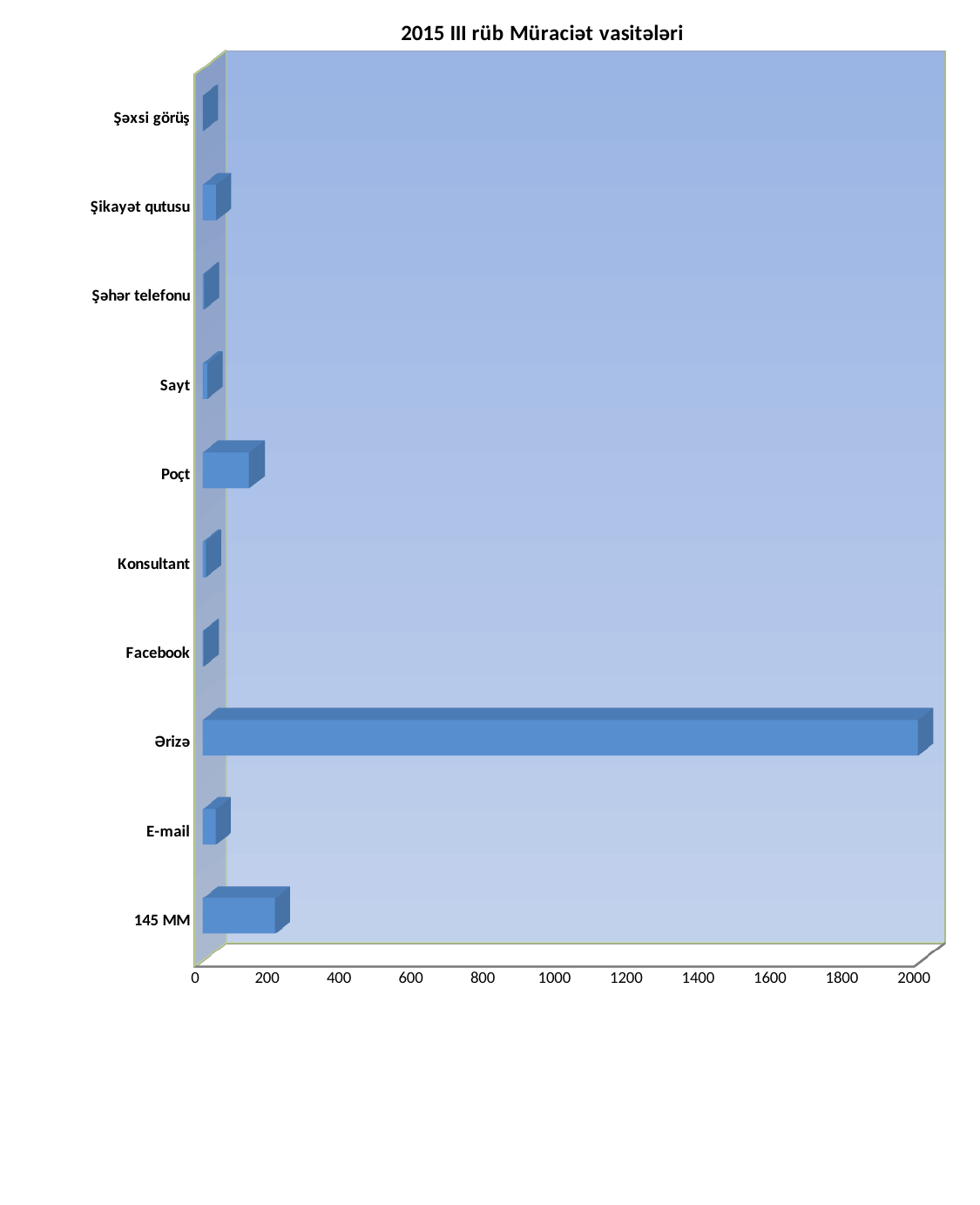
Is the value for Facebook greater or less than 200? less Is the value for 145 MM greater or less than 400? less Which is larger, the value for 145 MM or the value for Poçt? 145 MM Which is larger, the value for Ərizə or the value for Poçt? Ərizə Is the value for Poçt greater or less than 400? less How many categories are plotted in the chart? 10 What is the title of the chart? 2015 III rüb Müraciət vasitələri Which category has the highest value? Ərizə Which is larger, the value for Poçt or the value for Facebook? Poçt What kind of chart is shown on the slide? bar chart